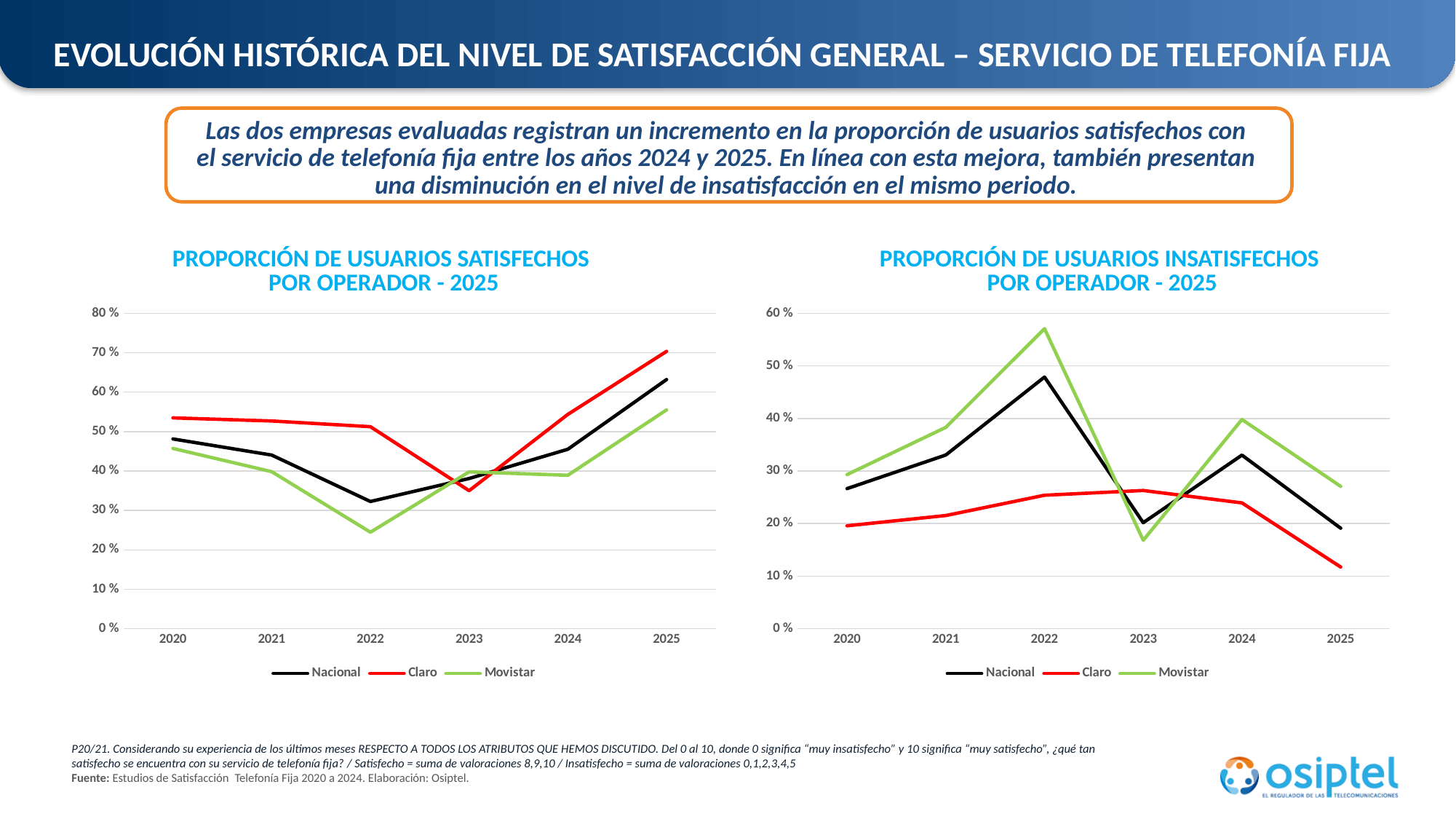
In the 'PROPORCIÓN DE USUARIOS INSATISFECHOS POR OPERADOR - 2025' chart, does the Claro line rise or fall from 2024 to 2025? Fall In the 'PROPORCIÓN DE USUARIOS INSATISFECHOS POR OPERADOR - 2025' chart, how many years are shown on the x axis? 6 In the 'PROPORCIÓN DE USUARIOS SATISFECHOS POR OPERADOR - 2025' chart, which series has the lowest value in 2022? Movistar What kind of chart is the 'PROPORCIÓN DE USUARIOS SATISFECHOS POR OPERADOR - 2025' chart? Line chart In the 'PROPORCIÓN DE USUARIOS SATISFECHOS POR OPERADOR - 2025' chart, what colour is the Claro line? Red In the 'PROPORCIÓN DE USUARIOS INSATISFECHOS POR OPERADOR - 2025' chart, which is larger in 2022, Movistar or Claro? Movistar In the 'PROPORCIÓN DE USUARIOS SATISFECHOS POR OPERADOR - 2025' chart, how many series does the legend list? 3 In the 'PROPORCIÓN DE USUARIOS SATISFECHOS POR OPERADOR - 2025' chart, is the value for Movistar in 2022 greater or less than 30 %? less In the 'PROPORCIÓN DE USUARIOS INSATISFECHOS POR OPERADOR - 2025' chart, is the value for Claro in 2025 greater or less than 20 %? less In the 'PROPORCIÓN DE USUARIOS SATISFECHOS POR OPERADOR - 2025' chart, is the value for Claro in 2025 greater or less than 60 %? greater In the 'PROPORCIÓN DE USUARIOS SATISFECHOS POR OPERADOR - 2025' chart, which series has the highest value in 2025? Claro In the 'PROPORCIÓN DE USUARIOS INSATISFECHOS POR OPERADOR - 2025' chart, in which year does Movistar reach its highest value? 2022